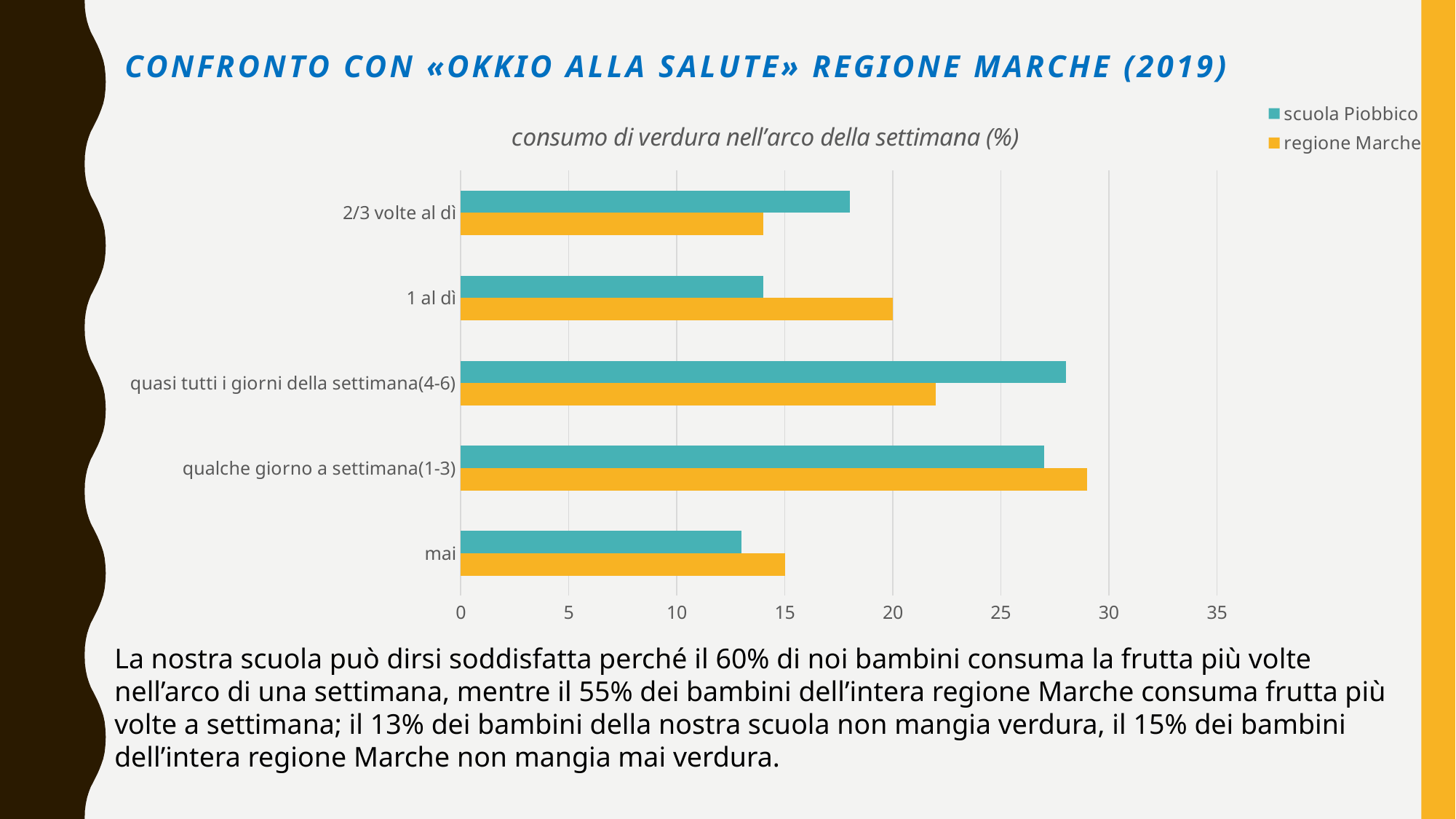
What is the value for regione Marche in the category "1 al dì"? 20 How many series does the legend list? 2 How many categories are shown on the chart? 5 For the category "quasi tutti i giorni della settimana(4-6)", which series has the larger value, scuola Piobbico or regione Marche? scuola Piobbico What is the title of the chart? consumo di verdura nell'arco della settimana (%) Is the value for scuola Piobbico in "1 al dì" greater or less than 15? less What kind of chart is shown on the slide? bar chart What is the value for regione Marche in the category "mai"? 15 Is the value for regione Marche in "qualche giorno a settimana(1-3)" greater or less than 25? greater For the category "1 al dì", which series has the larger value, scuola Piobbico or regione Marche? regione Marche Which category has the highest value for regione Marche? qualche giorno a settimana(1-3) Is the value for scuola Piobbico in "quasi tutti i giorni della settimana(4-6)" greater or less than 25? greater